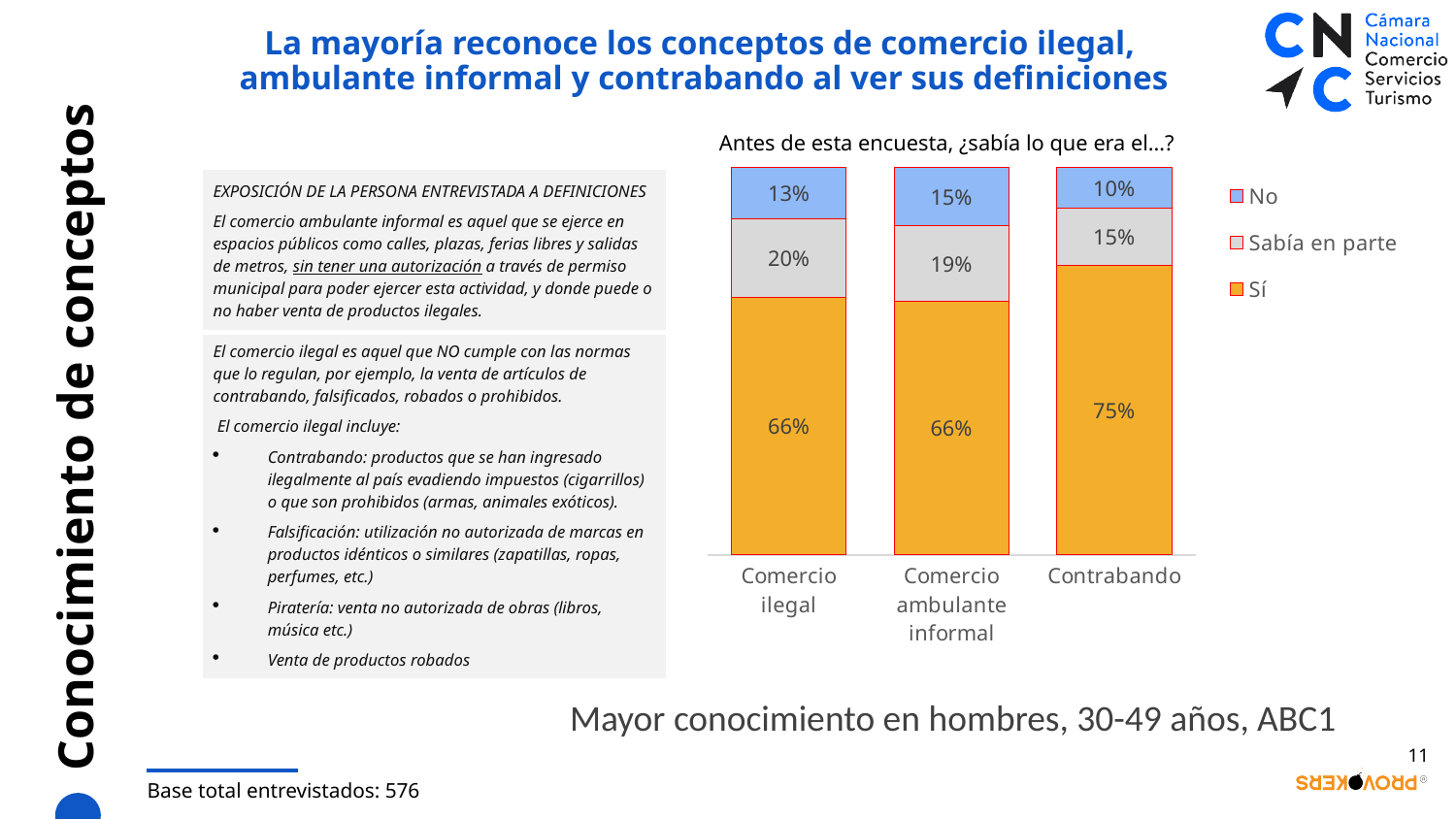
What is the "No" value for Comercio ambulante informal? 15% Which category has the highest "Sí" share? Contrabando What is the difference between the "Sí" value for Contrabando and the "Sí" value for Comercio ilegal? 9% How many categories are shown on the x axis of the chart? 3 What kind of chart is shown on the slide? Stacked bar chart Which is larger: the "Sabía en parte" value for Comercio ilegal or for Contrabando? Comercio ilegal How many series does the legend list? 3 What percentage of respondents answered "Sí" for Contrabando? 75% Which category has the lowest "No" share? Contrabando What is the "Sabía en parte" value for Comercio ilegal? 20% What is the title shown above the chart? Antes de esta encuesta, ¿sabía lo que era el…? What is the total of the stacked bar for Contrabando? 100%